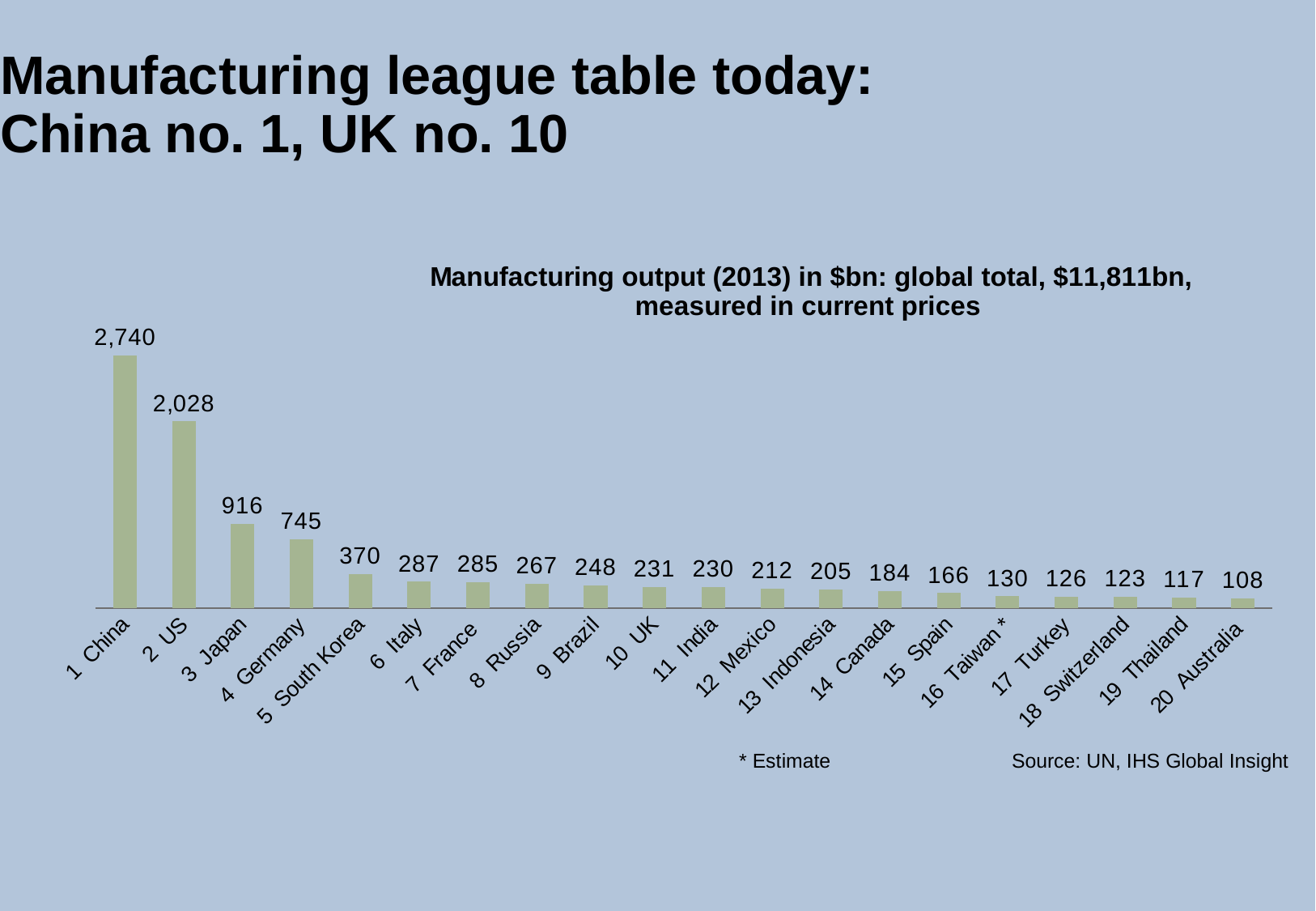
What is the value shown for Germany? 745 What is the manufacturing output value shown for the UK? 231 Do the values rise or fall from left to right along the x axis? Fall What kind of chart is shown on the slide? Bar chart Which country has the highest manufacturing output in the chart? China Which country has the lowest manufacturing output in the chart? Australia What is the difference between the values for Japan and Germany? 171 What is the title of the chart? Manufacturing output (2013) in $bn: global total, $11,811bn, measured in current prices What is the difference between the values for China and the US? 712 How many countries are shown in the chart? 20 Which has a larger value, South Korea or Italy? South Korea What is the manufacturing output value shown for China? 2,740